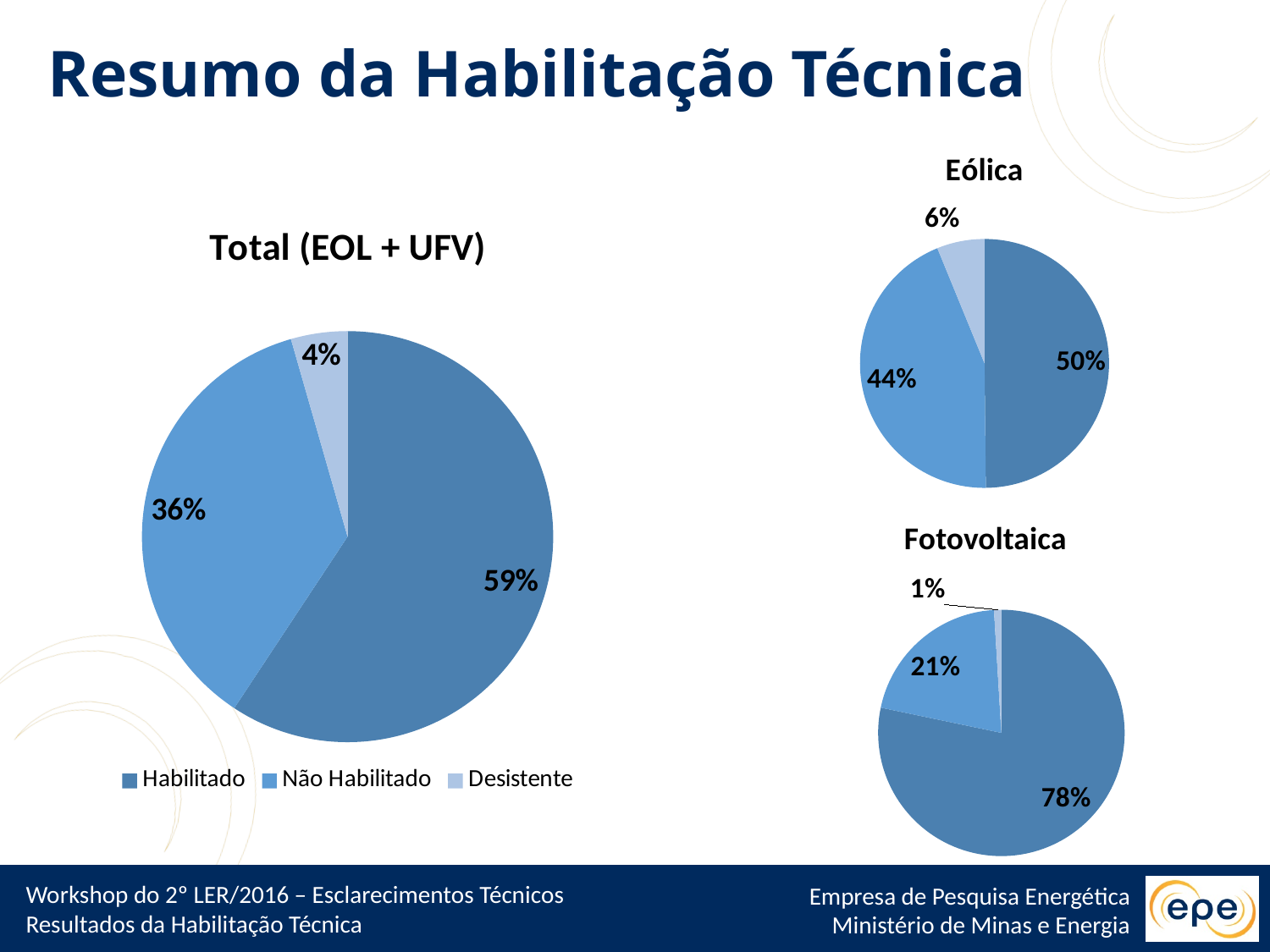
In the "Eólica" chart, what is the largest share shown? 50% How many pie charts are on the slide? 3 In the "Total (EOL + UFV)" chart, what share is Habilitado? 59% How many entries does the legend of the "Total (EOL + UFV)" chart list? 3 In the "Eólica" chart, what is the smallest share shown? 6% In the "Total (EOL + UFV)" chart, what is the difference between the Habilitado and Não Habilitado shares? 23% In the "Total (EOL + UFV)" chart, which category has the largest slice? Habilitado In the "Total (EOL + UFV)" chart, which category has the smallest slice? Desistente In the "Total (EOL + UFV)" chart, what share is Desistente? 4% What kind of chart is the "Total (EOL + UFV)" chart? pie chart In the "Total (EOL + UFV)" chart, what share is Não Habilitado? 36% In the "Fotovoltaica" chart, what is the largest share shown? 78%